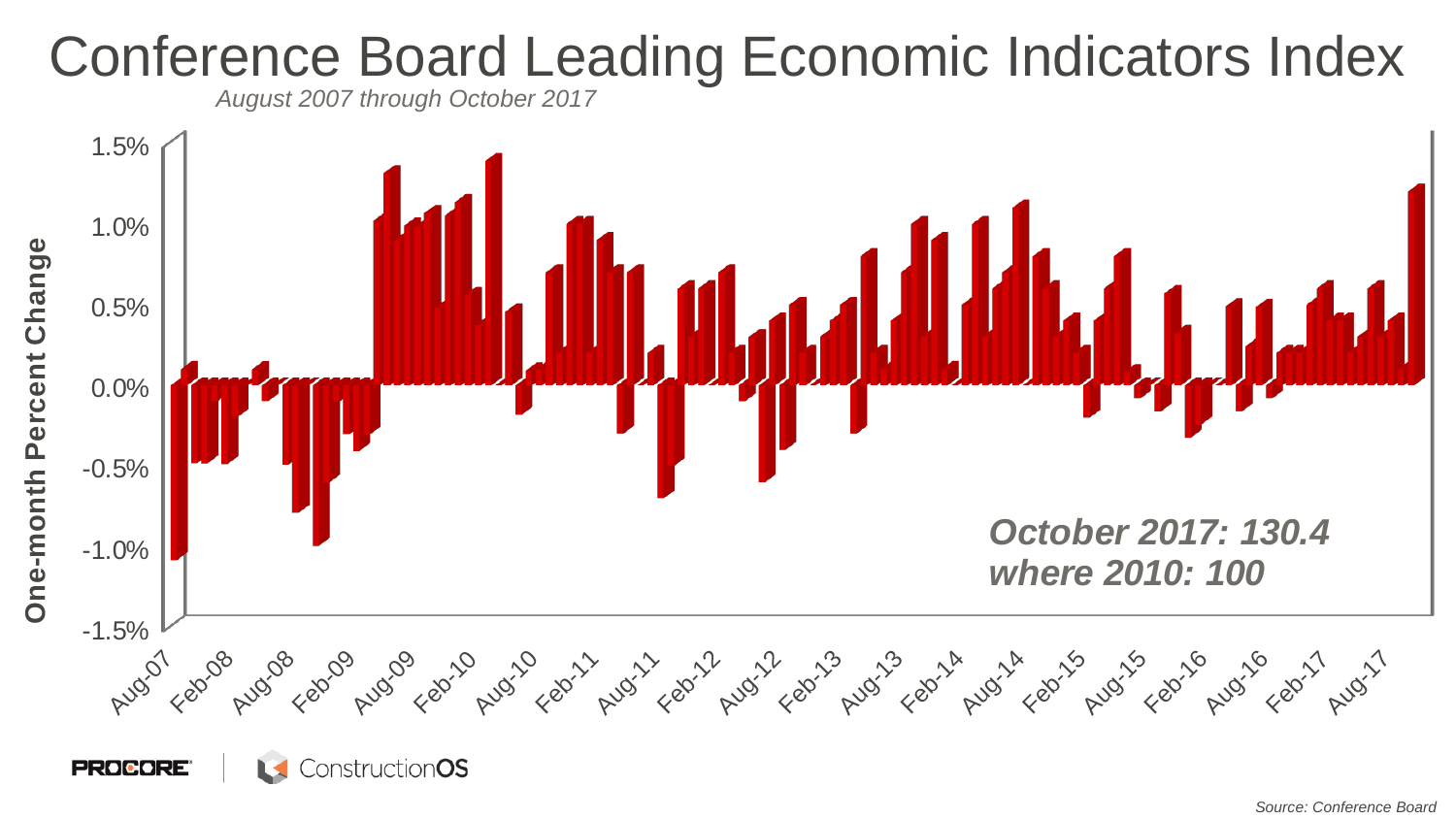
According to the annotation, what base year is set to 100 for the index? 2010 What kind of chart is shown on the slide? Bar chart What period does the chart cover, according to its subtitle? August 2007 through October 2017 Is the value for the first bar (Aug-07) greater or less than -0.5%? less Is the value for the last bar (October 2017) greater or less than 1.0%? greater What is the label on the vertical axis? One-month Percent Change What is the highest value shown on the vertical axis? 1.5% How many month labels are shown along the horizontal axis? 21 What is the lowest value shown on the vertical axis? -1.5% What index value is given for October 2017 in the annotation on the chart? 130.4 Which is larger, the value for the first bar (Aug-07) or the value for the last bar (Oct-17)? Oct-17 What is the title of the chart? Conference Board Leading Economic Indicators Index